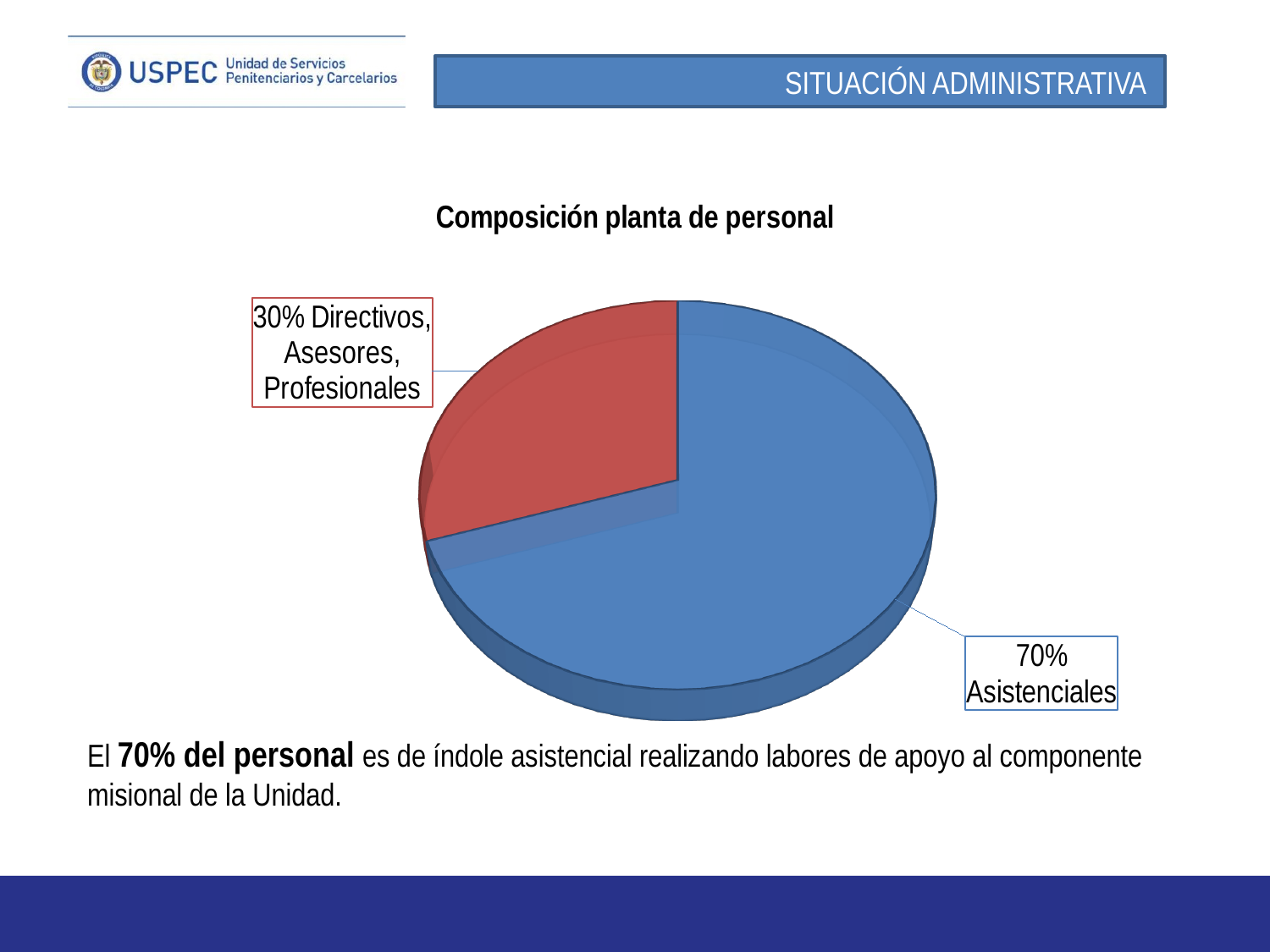
How many slices does the pie chart have? 2 Which is larger: the Asistenciales slice or the Directivos, Asesores, Profesionales slice? Asistenciales What is the title of the chart? Composición planta de personal What colour is the Asistenciales slice? Blue What share of the pie is Directivos, Asesores, Profesionales? 30% Is the share for Directivos, Asesores, Profesionales greater or less than 50%? less What kind of chart is shown on the slide? Pie chart Which slice of the pie is the largest? Asistenciales What share of the pie is Asistenciales? 70% What is the difference in percentage points between the Asistenciales slice and the Directivos, Asesores, Profesionales slice? 40 percentage points Which slice of the pie is the smallest? Directivos, Asesores, Profesionales